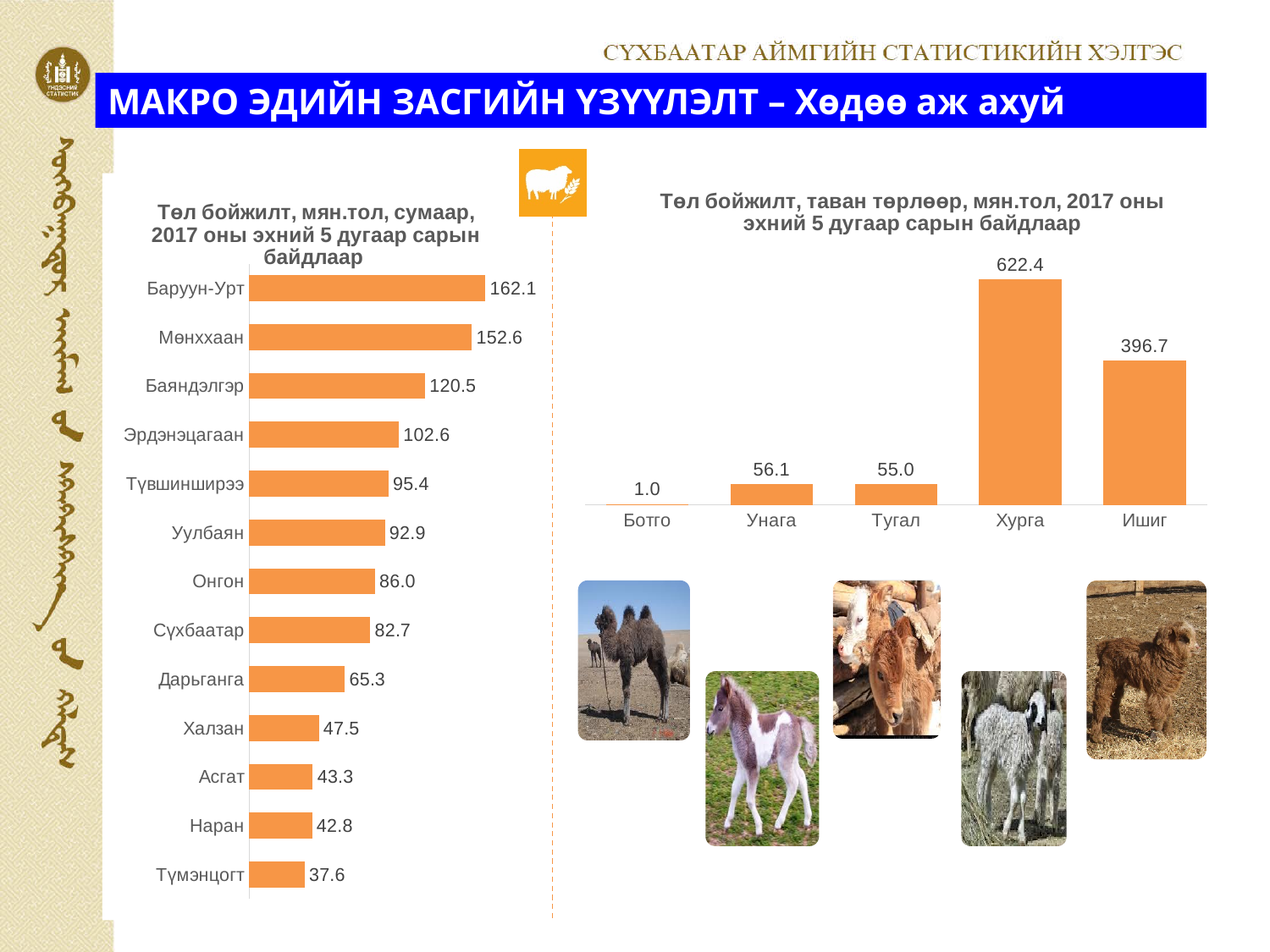
In the left chart (Төл бойжилт, мян.тол, сумаар), what is the value for Баруун-Урт? 162.1 In the right chart (Төл бойжилт, таван төрлөөр), what is the value for Хурга? 622.4 In the left chart (Төл бойжилт, мян.тол, сумаар), how many soums are shown? 13 In the right chart (Төл бойжилт, таван төрлөөр), which is larger, Унага or Тугал? Унага In the left chart (Төл бойжилт, мян.тол, сумаар), what is the value for Дарьганга? 65.3 In the left chart (Төл бойжилт, мян.тол, сумаар), what is the difference between Баруун-Урт and Мөнххаан? 9.5 In the right chart (Төл бойжилт, таван төрлөөр), which category has the lowest value? Ботго In the right chart (Төл бойжилт, таван төрлөөр), what is the difference between Хурга and Ишиг? 225.7 In the left chart (Төл бойжилт, мян.тол, сумаар), which soum has the lowest value? Түмэнцогт In the right chart (Төл бойжилт, таван төрлөөр), how many categories are shown? 5 What kind of chart is the left chart (Төл бойжилт, мян.тол, сумаар)? Bar chart In the left chart (Төл бойжилт, мян.тол, сумаар), which is larger, Онгон or Сүхбаатар? Онгон